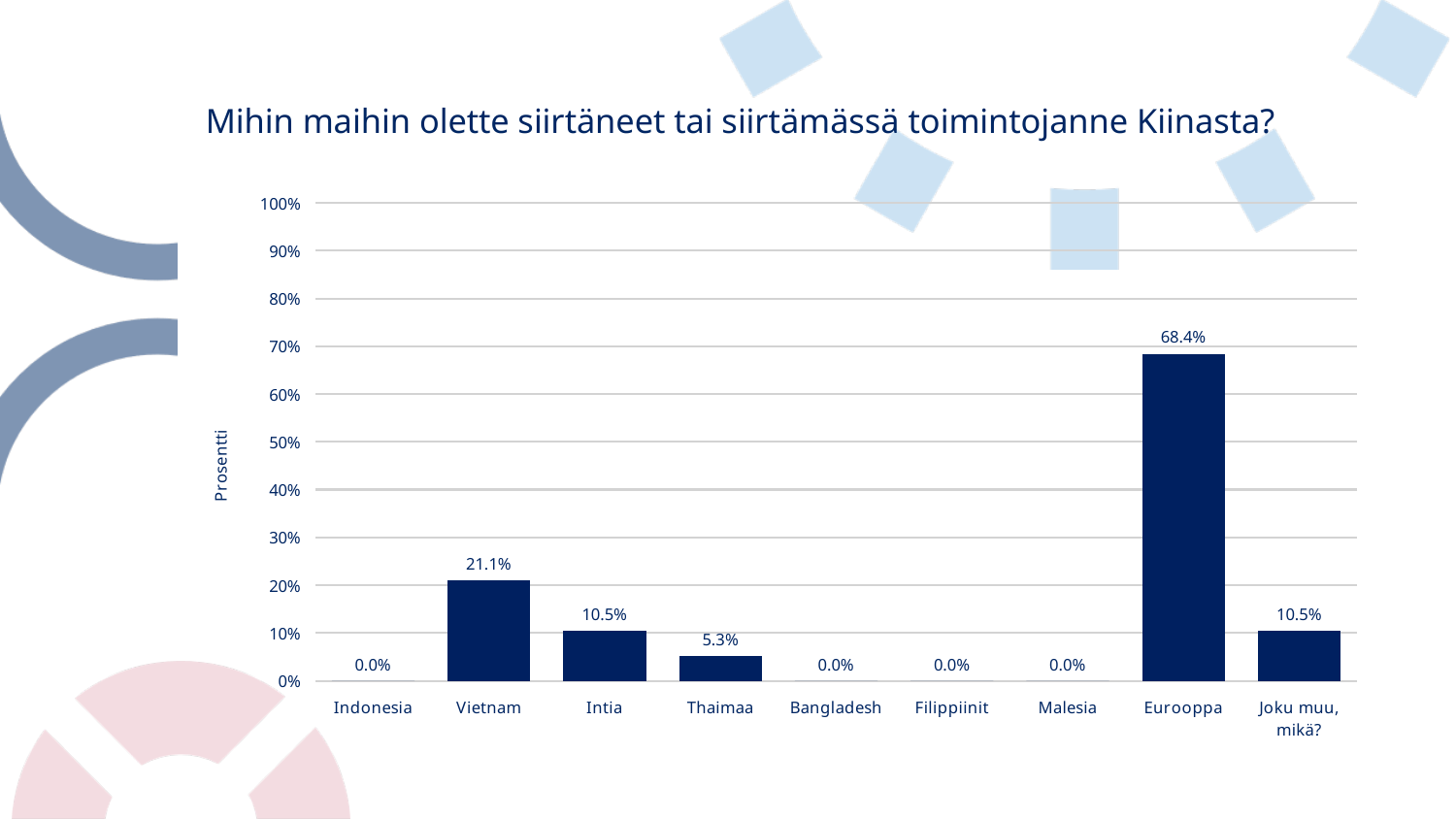
How many categories are shown on the x axis? 9 What is the value for Thaimaa? 5.3% What is the value for Eurooppa? 68.4% What is the value for Intia? 10.5% What is the value for Vietnam? 21.1% Which category has the highest value? Eurooppa What is the label of the y axis? Prosentti What kind of chart is shown on the slide? bar chart How many categories have a value of 0.0%? 4 Is the value for Eurooppa greater or less than 60%? greater What is the difference between the values for Eurooppa and Vietnam? 47.3% Which is larger, the value for Vietnam or the value for Intia? Vietnam